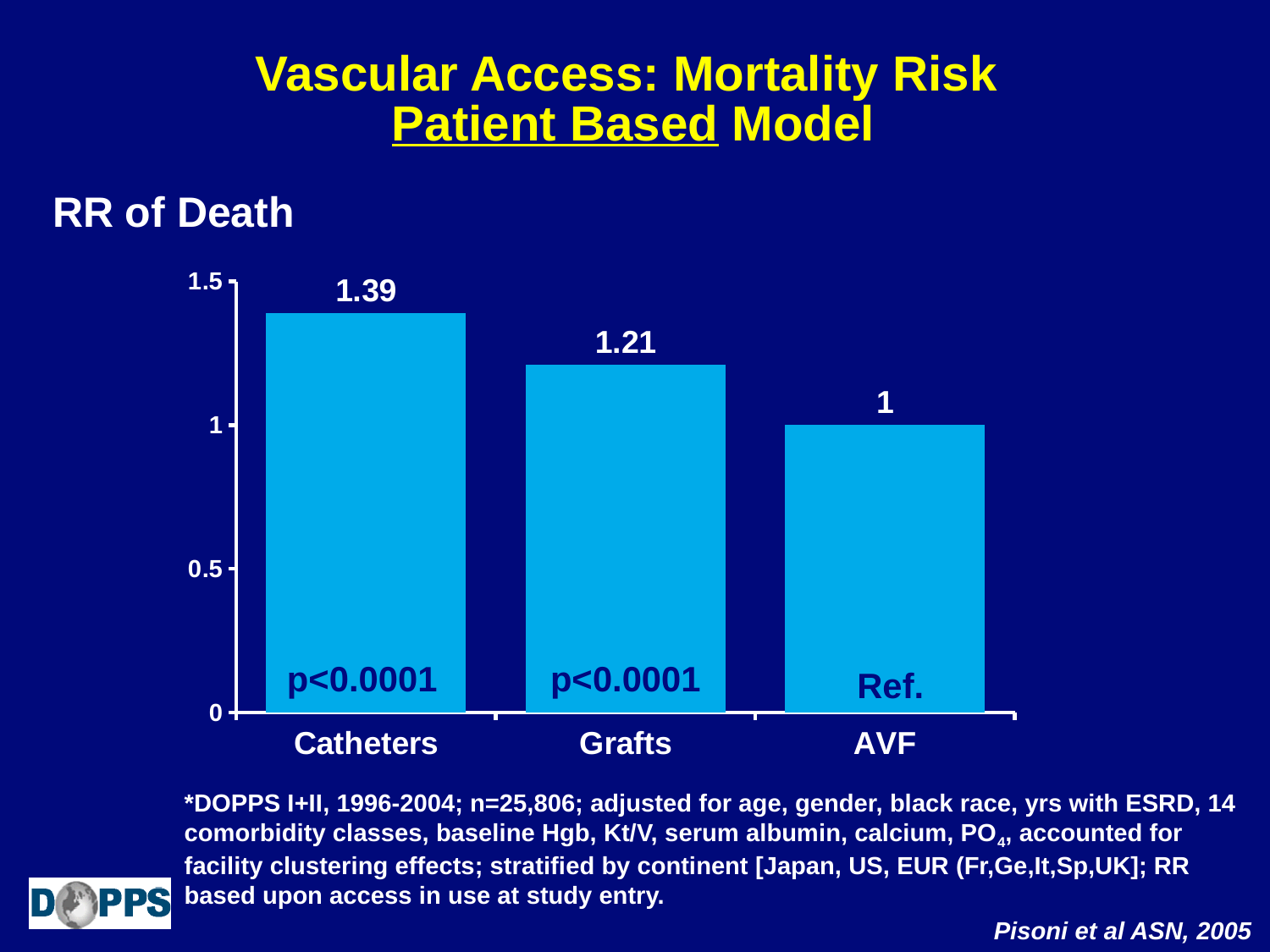
What is the difference in RR of Death between Catheters and Grafts? 0.18 Which has a higher RR of Death, Catheters or Grafts? Catheters Which category is labelled as the reference (Ref.) group in the chart? AVF Is the RR of Death for Grafts greater or less than 1? greater What is the RR of Death for Catheters? 1.39 What is the RR of Death for AVF? 1 Which vascular access type has the highest RR of Death? Catheters What kind of chart is shown on the slide? Bar chart Which vascular access type has the lowest RR of Death? AVF What is the difference in RR of Death between Grafts and AVF? 0.21 What is the RR of Death for Grafts? 1.21 How many vascular access categories are shown in the chart? 3